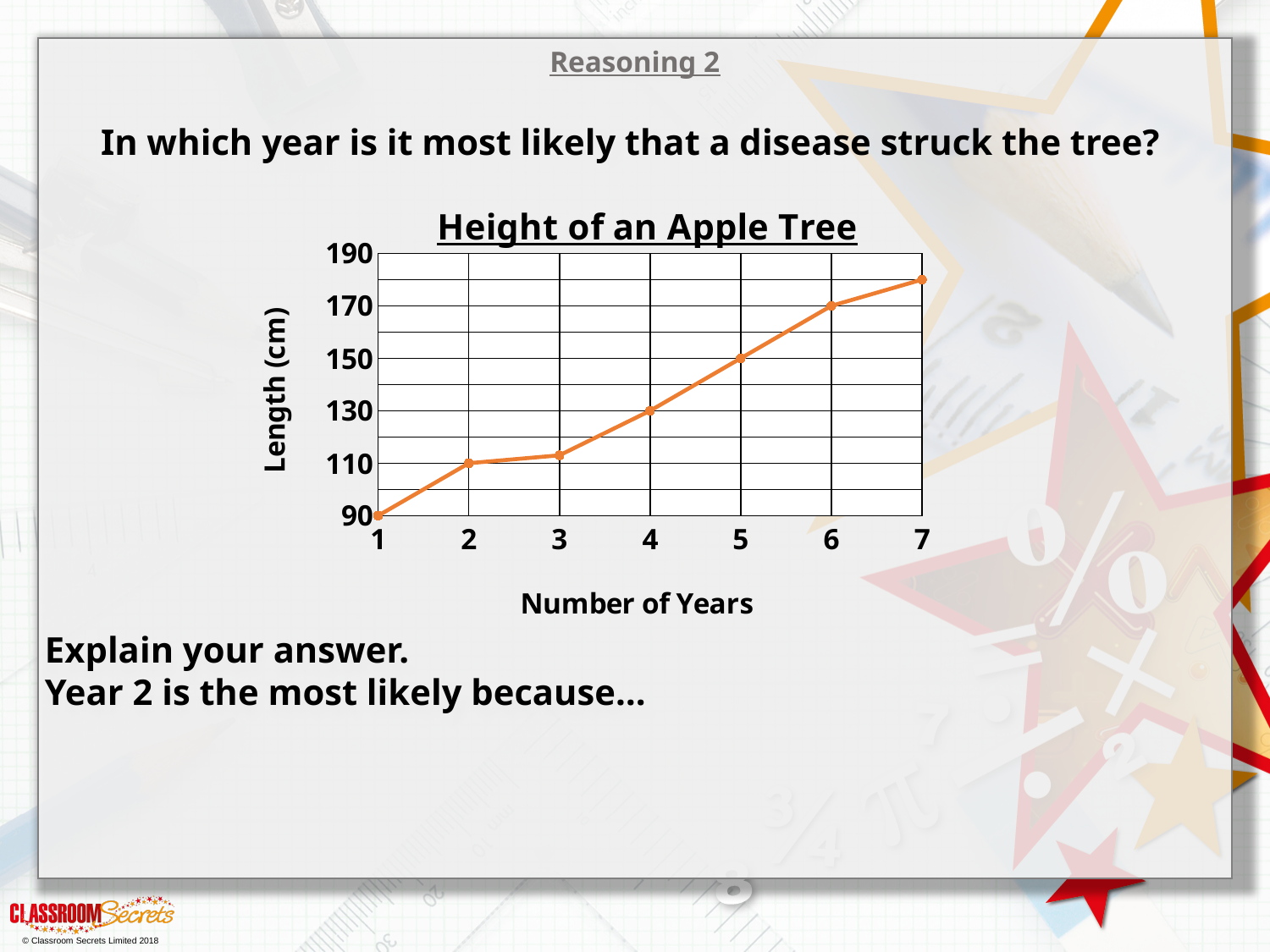
Is the height at year 7 greater or less than 170? greater What is the height of the apple tree at year 6? 170 What is the difference in height between year 6 and year 4? 40 What is the height of the apple tree at year 1? 90 What type of chart is shown on the slide? Line chart How many years are plotted on the x axis? 7 Does the height of the tree rise or fall as the number of years increases? Rise In which year is the tree's height the greatest? 7 In which year is the tree's height the lowest? 1 What is the height of the apple tree at year 2? 110 What is the height of the apple tree at year 5? 150 What is the title of the chart? Height of an Apple Tree